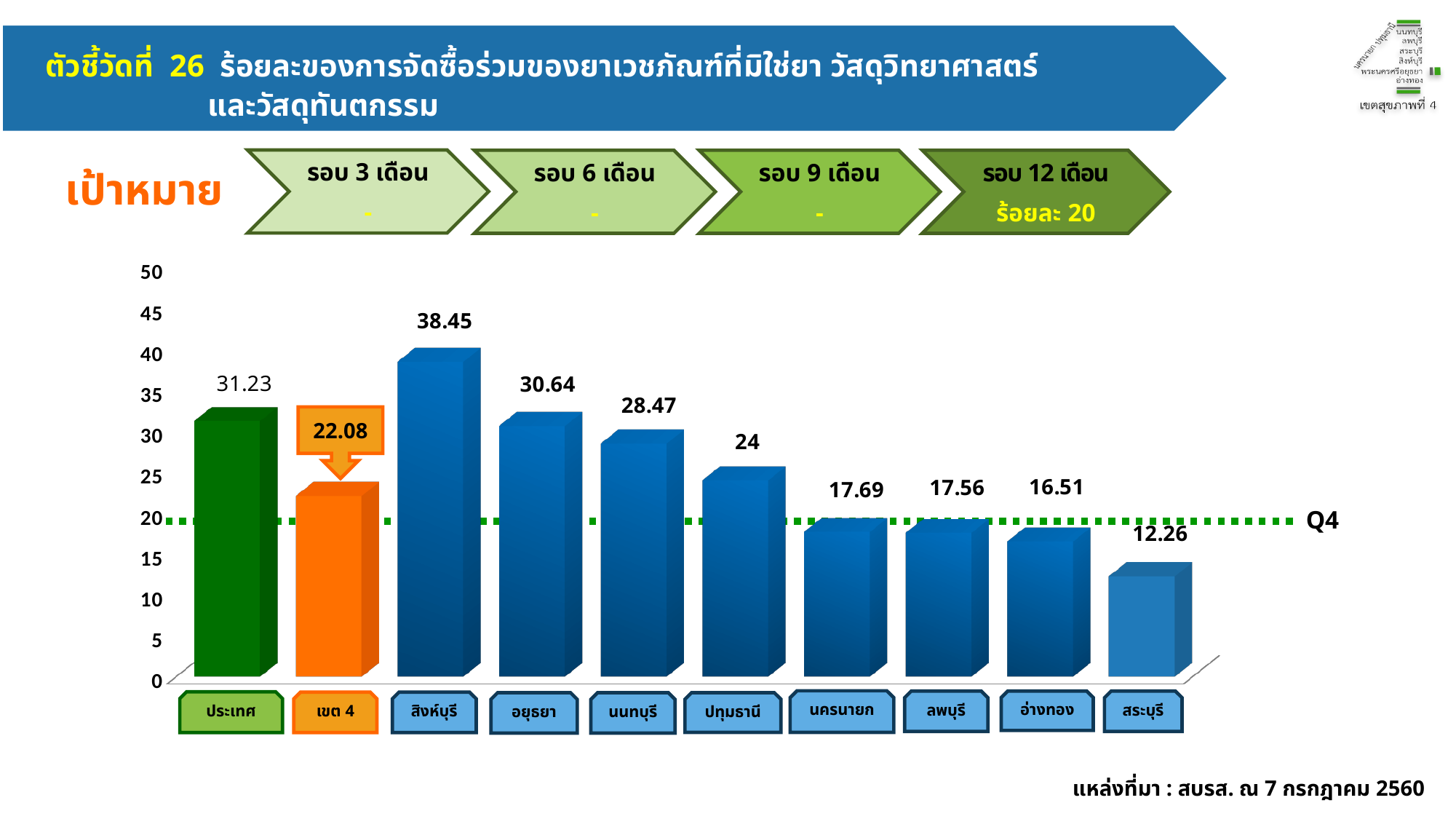
Which category has the lowest value? สระบุรี What is the value for สิงห์บุรี? 38.45 How many categories are shown on the x axis? 10 What is the value for ประเทศ? 31.23 What is the value for เขต 4? 22.08 Is the value for อ่างทอง greater or less than 20? less What is the value for ปทุมธานี? 24 Which is larger, the value for อยุธยา or the value for นนทบุรี? อยุธยา What kind of chart is shown on the slide? bar chart Which category has the highest value? สิงห์บุรี What is the label on the dashed horizontal line at 20? Q4 What is the difference between the values for สิงห์บุรี and สระบุรี? 26.19